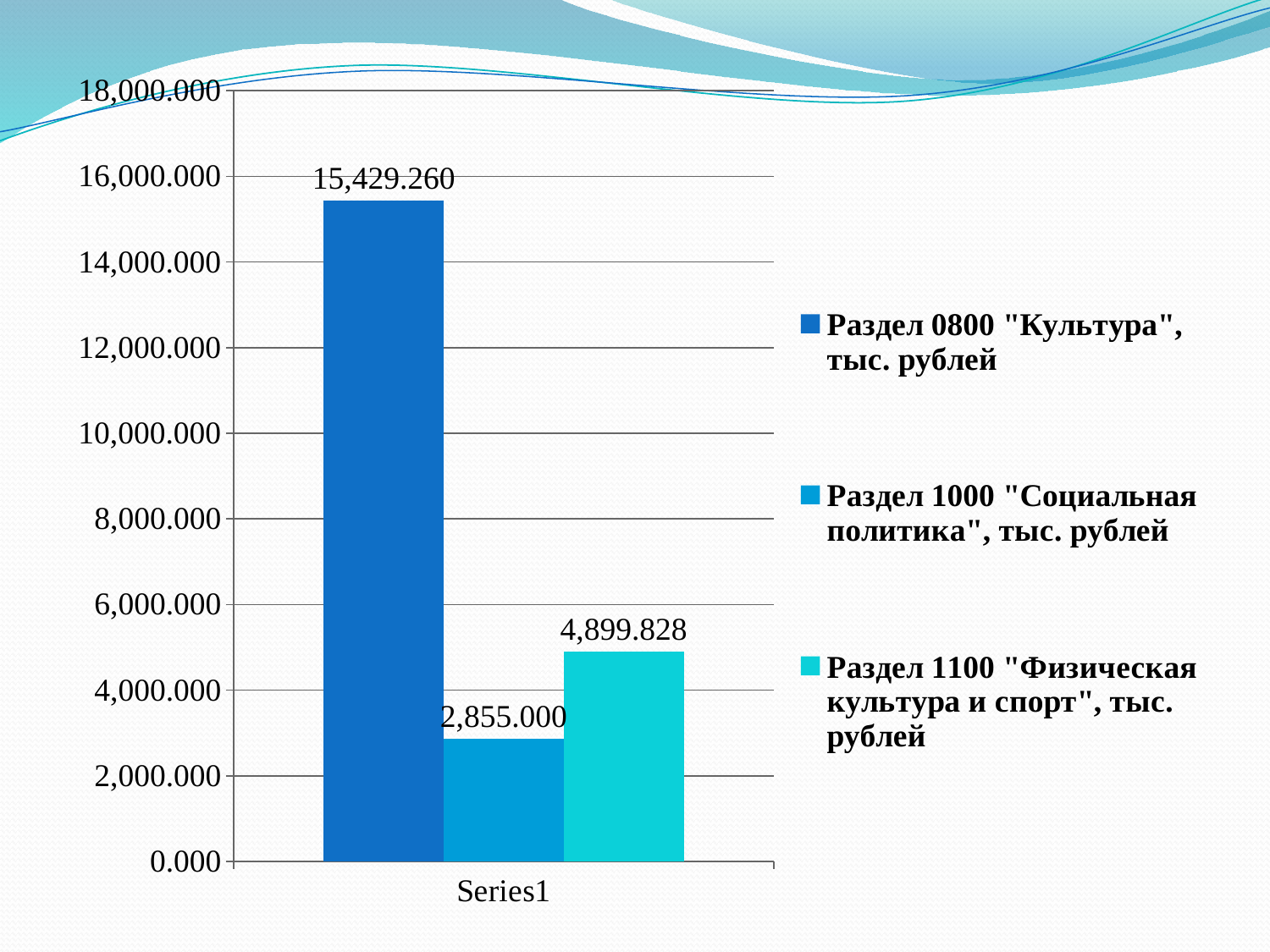
What is the difference between the values for Раздел 1100 "Физическая культура и спорт" and Раздел 1000 "Социальная политика"? 2,044.828 Which is larger: the value for Раздел 1100 "Физическая культура и спорт" or Раздел 1000 "Социальная политика"? Раздел 1100 "Физическая культура и спорт", тыс. рублей What is the difference between the values for Раздел 0800 "Культура" and Раздел 1000 "Социальная политика"? 12,574.260 What is the label shown on the x axis under the bars? Series1 What is the value for Раздел 0800 "Культура", тыс. рублей? 15,429.260 How many series does the legend list? 3 Which series has the highest value? Раздел 0800 "Культура", тыс. рублей What is the value for Раздел 1000 "Социальная политика", тыс. рублей? 2,855.000 What is the value for Раздел 1100 "Физическая культура и спорт", тыс. рублей? 4,899.828 What kind of chart is shown on the slide? bar chart Is the value for Раздел 0800 "Культура" greater or less than 14,000.000? greater Which series has the lowest value? Раздел 1000 "Социальная политика", тыс. рублей